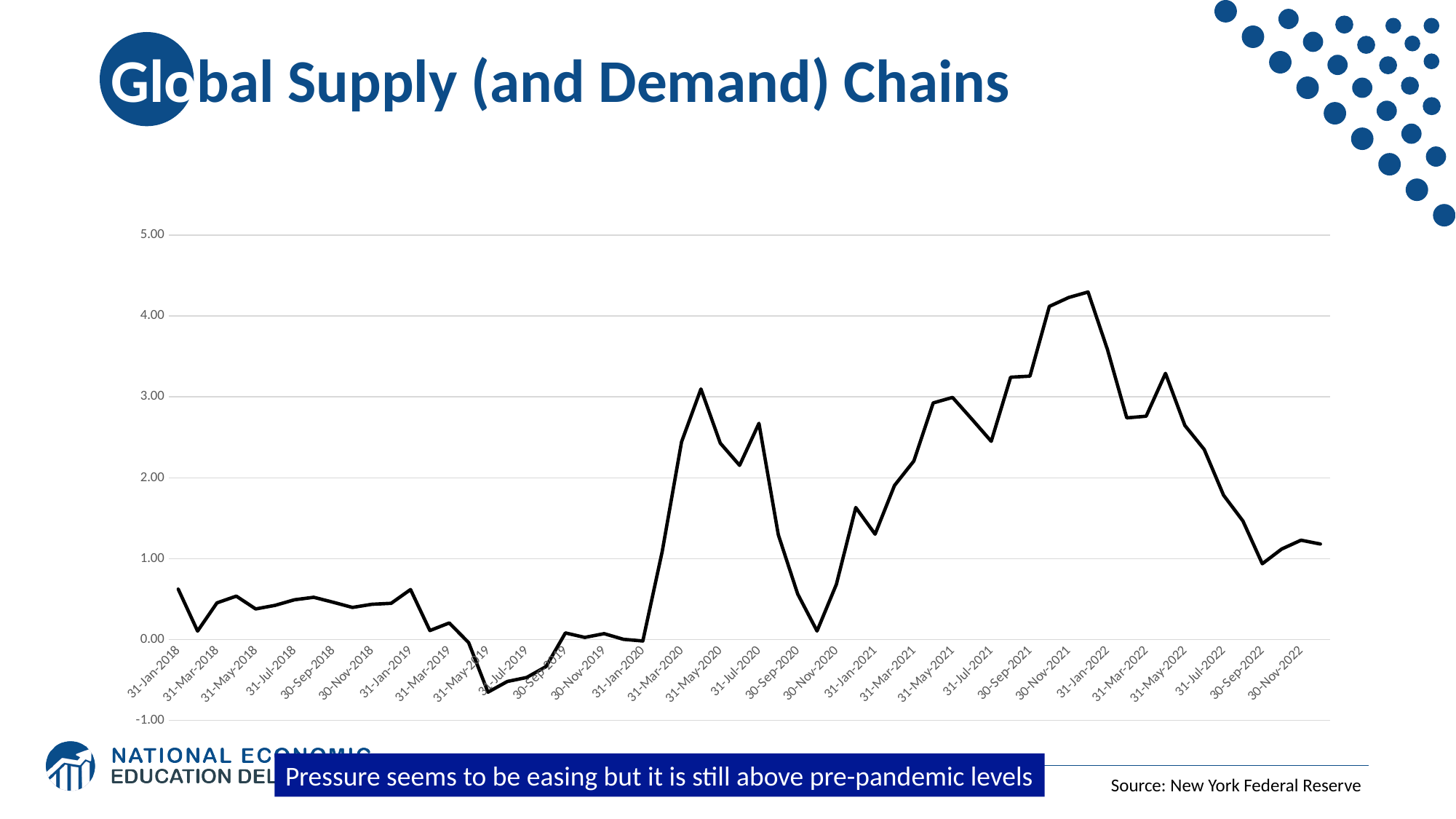
Is the value for 30-Nov-2020 greater or less than 1.00? less Is the value for 31-Mar-2020 greater or less than 2.00? greater Is the value for 31-Jul-2022 greater or less than 2.00? less Do the values rise or fall from 31-Jan-2022 to 30-Nov-2022? fall What kind of chart is shown on the slide? line chart Which is larger, the value for 31-Jan-2022 or the value for 31-Jan-2018? 31-Jan-2022 How many lines are plotted on the chart? 1 What source is cited for the chart? New York Federal Reserve Do the values rise or fall from 30-Nov-2020 to 31-May-2021? rise Which is larger, the value for 31-Mar-2020 or the value for 30-Nov-2020? 31-Mar-2020